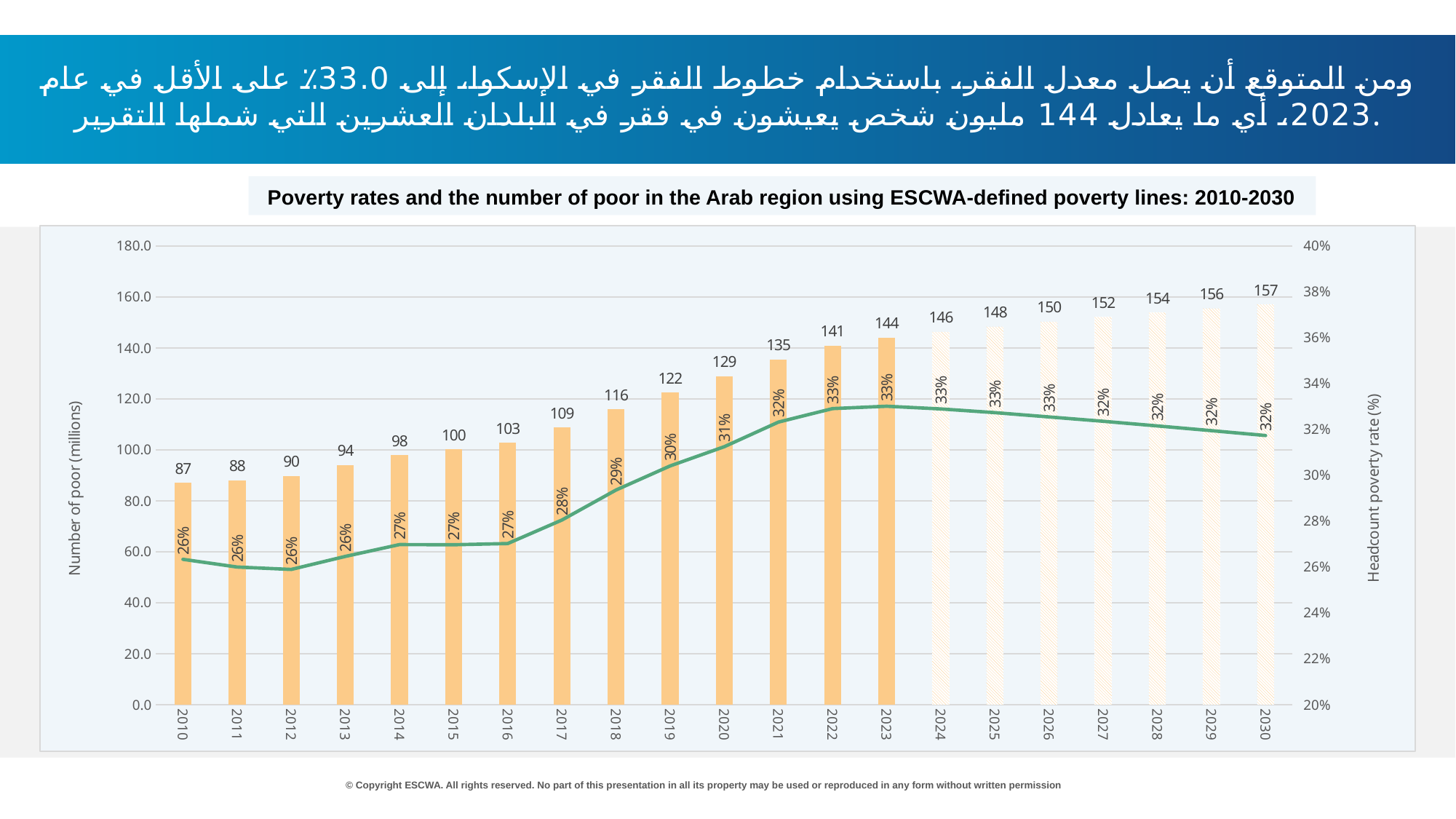
Which year has the highest number of poor (millions)? 2030 What is the difference in the number of poor (millions) between 2030 and 2010? 70 Do the bars for the number of poor rise or fall from 2010 to 2030? Rise How many years are plotted on the x axis? 21 What is the label of the right-hand vertical axis? Headcount poverty rate (%) What headcount poverty rate is labelled for 2019? 30% Which year has the lowest number of poor (millions)? 2010 What kind of chart is this? Combined bar and line chart What is the number of poor (millions) shown for 2023? 144 What is the title of the chart? Poverty rates and the number of poor in the Arab region using ESCWA-defined poverty lines: 2010-2030 Which year has a larger number of poor, 2018 or 2021? 2021 What is the number of poor (millions) shown for 2010? 87